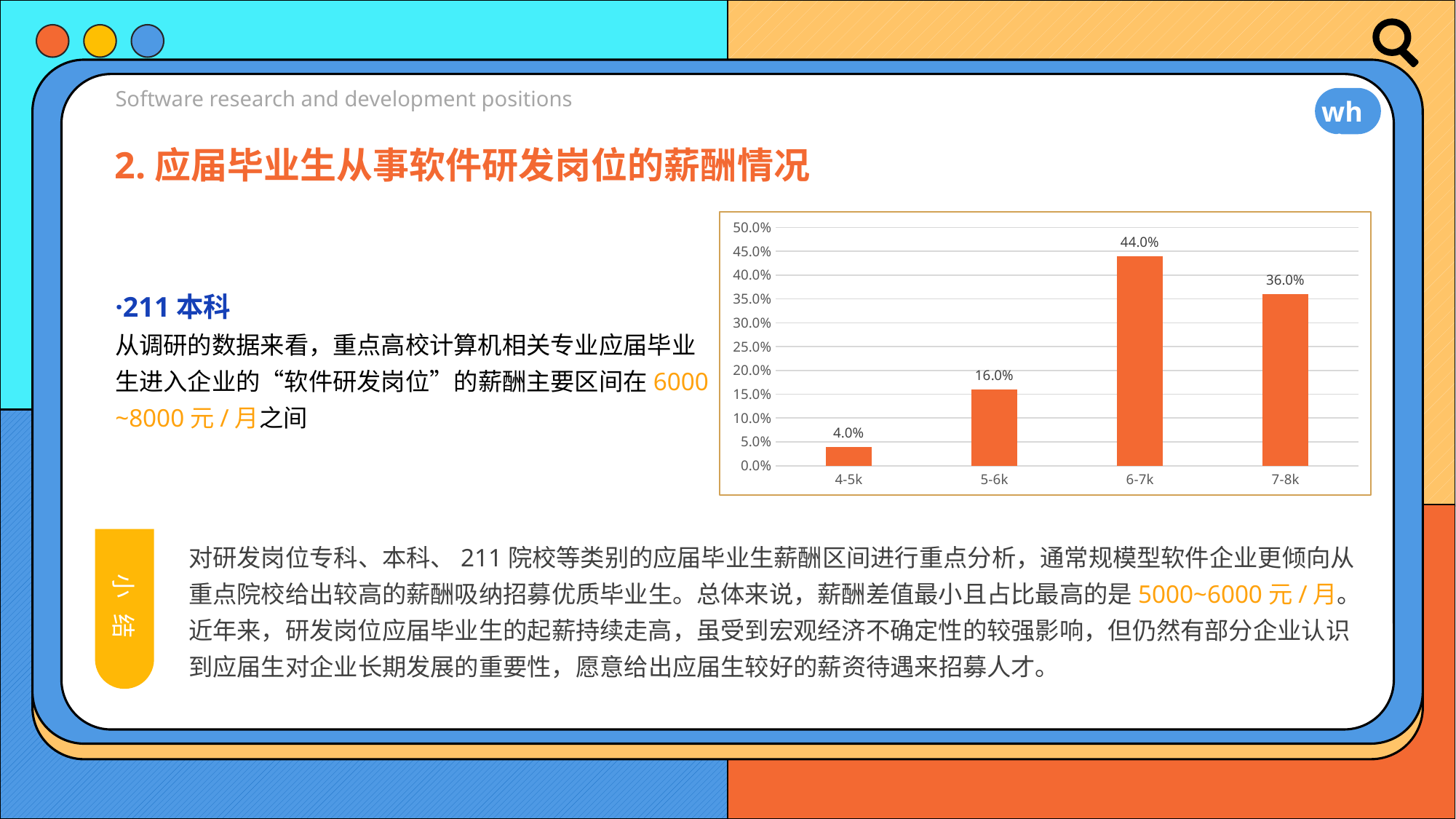
What is the value for the 4-5k category? 4.0% Which is larger, the value for 5-6k or the value for 7-8k? 7-8k Which category has the highest value? 6-7k Which category has the lowest value? 4-5k Is the value for 7-8k greater or less than 30.0%? greater What is the difference between the values for 6-7k and 7-8k? 8.0% What is the value for the 6-7k category? 44.0% What kind of chart is shown on the slide? bar chart How many categories are shown on the x axis? 4 What is the value for the 5-6k category? 16.0% What is the highest value shown on the y axis? 50.0% What is the value for the 7-8k category? 36.0%